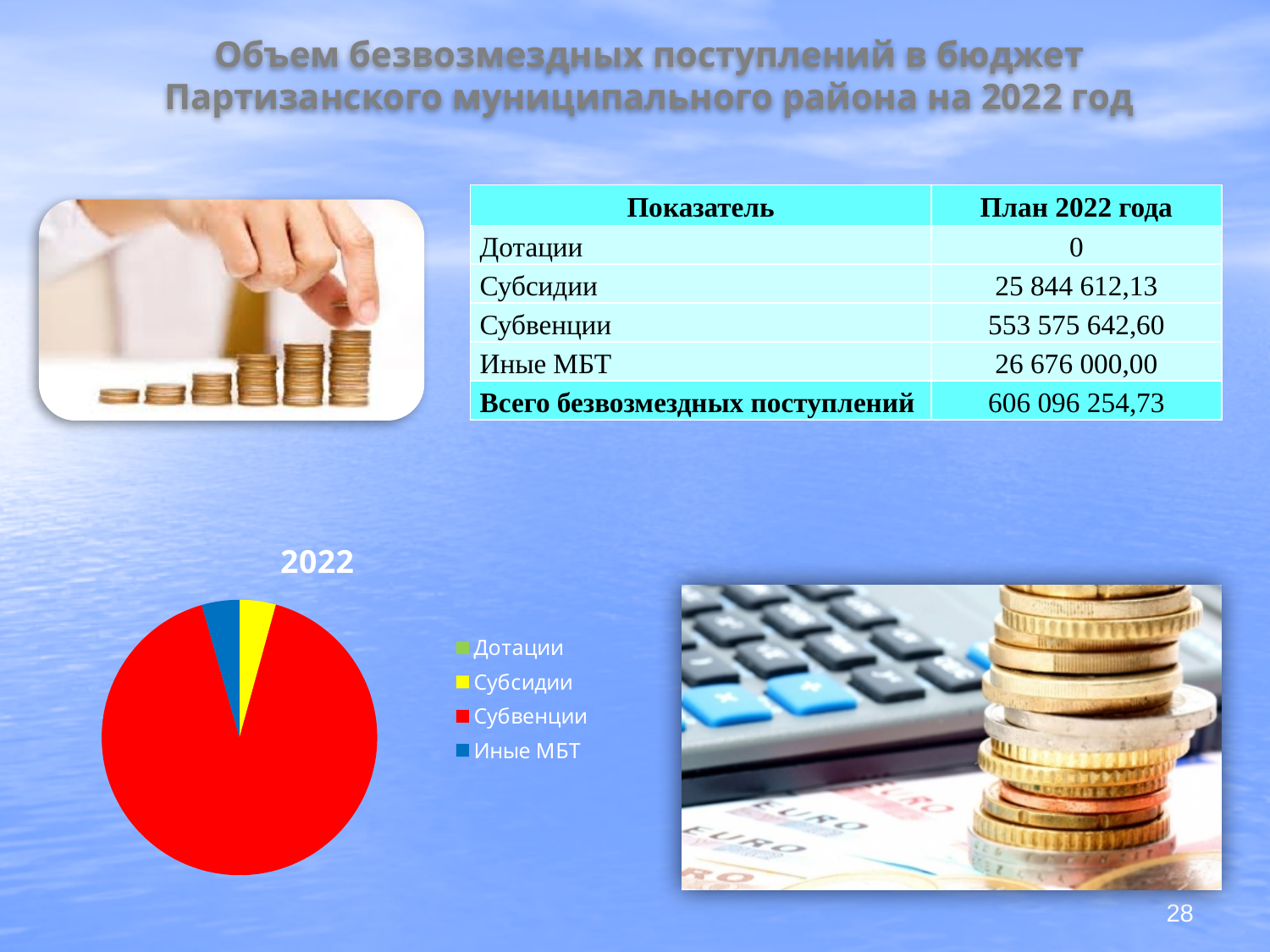
What is the planned 2022 value for Дотации shown on the slide? 0 How many entries does the legend of the pie chart list? 4 What colour is the Субвенции slice in the pie chart? red What kind of chart is shown at the bottom left of the slide? pie chart Which category has the smallest value in the pie chart (it does not appear as a visible slice)? Дотации What is the total of all безвозмездные поступления for 2022 shown on the slide? 606 096 254,73 By how much does the Субвенции value exceed the Субсидии value? 527 731 030,47 What is the planned 2022 value for Субвенции shown on the slide? 553 575 642,60 Which category takes up the largest slice of the pie chart? Субвенции What is the planned 2022 value for Иные МБТ shown on the slide? 26 676 000,00 What is the title of the pie chart? 2022 What is the planned 2022 value for Субсидии shown on the slide? 25 844 612,13